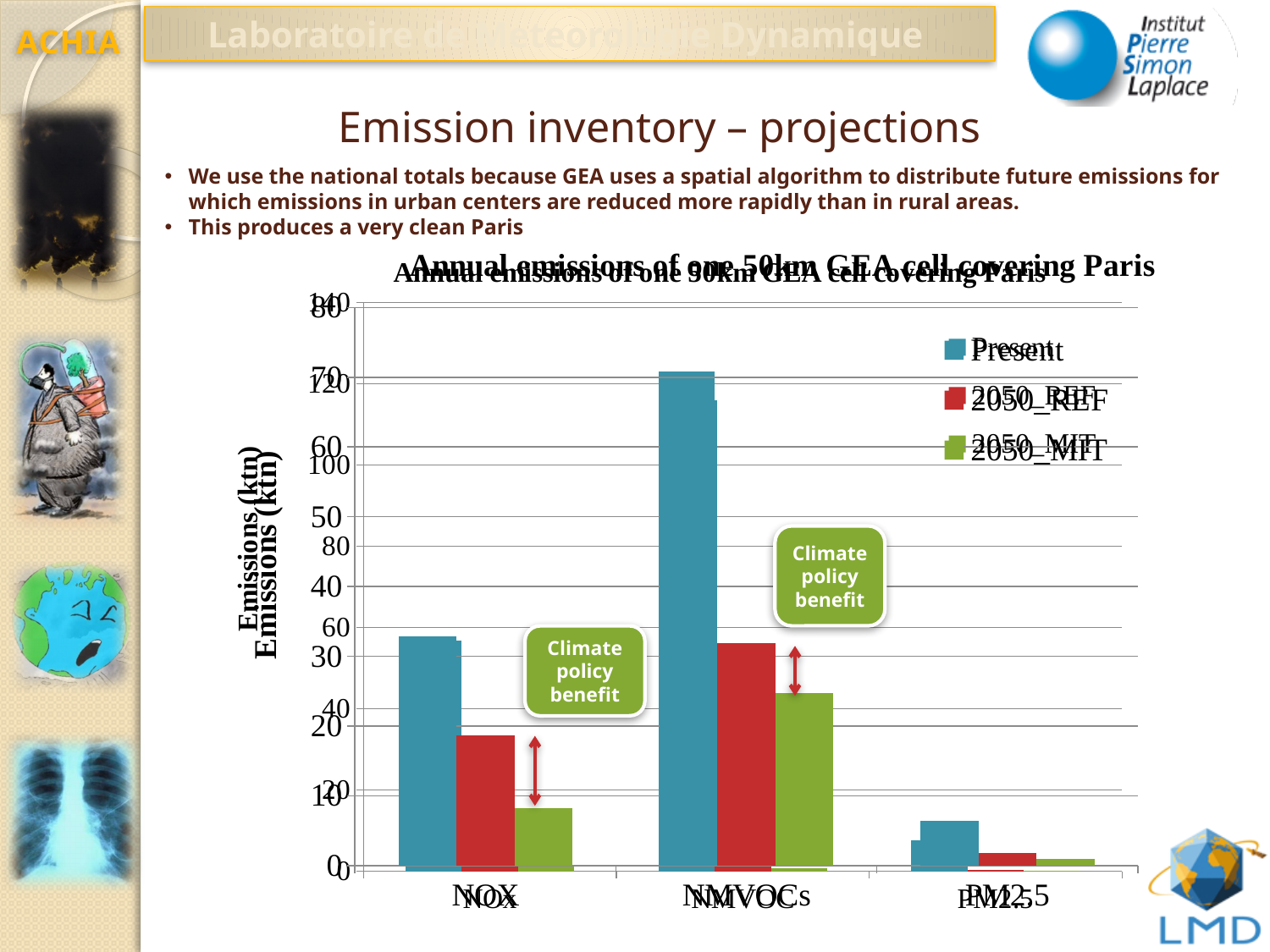
Which category has the highest Present emissions? NMVOCs For NOX, is the 2050_REF value larger or smaller than the 2050_MIT value? larger For NOX, which series has the highest value? Present What kind of chart is shown on the slide? bar chart Is the Present value for NMVOCs larger or smaller than the Present value for NOX? larger For NMVOCs, which series has the lowest value? 2050_MIT What is the title of the chart? Annual emissions of one 50km GEA cell covering Paris Within each category, do the values rise or fall going from Present to 2050_REF to 2050_MIT? fall How many categories are shown on the x axis of the chart? 3 Which category has the lowest Present emissions? PM2.5 Which series are listed in the chart legend? Present, 2050_REF, 2050_MIT How many series does the chart legend list? 3